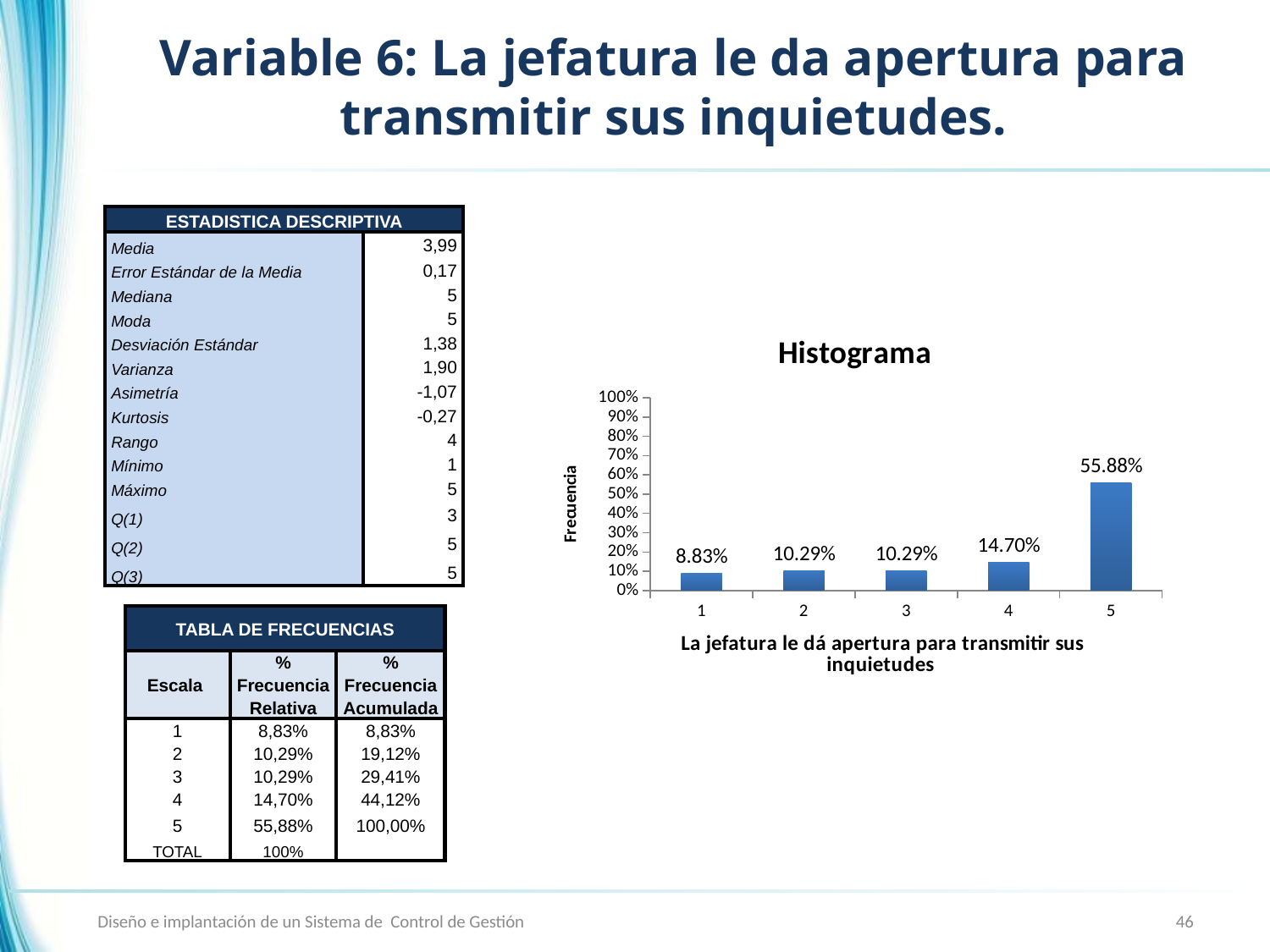
Which category has the highest value in the Histograma chart? 5 What is the difference between the values for category 4 and category 1 in the Histograma chart? 5.87% What kind of chart is the Histograma chart? bar chart Which is larger in the Histograma chart, the value for category 4 or the value for category 2? category 4 What is the difference between the values for category 5 and category 4 in the Histograma chart? 41.18% What is the y-axis label of the Histograma chart? Frecuencia What is the value for category 1 in the Histograma chart? 8.83% How many categories are shown on the x axis of the Histograma chart? 5 What is the value for category 4 in the Histograma chart? 14.70% Which category has the lowest value in the Histograma chart? 1 What is the value for category 5 in the Histograma chart? 55.88% Is the value for category 5 in the Histograma chart greater or less than 50%? greater